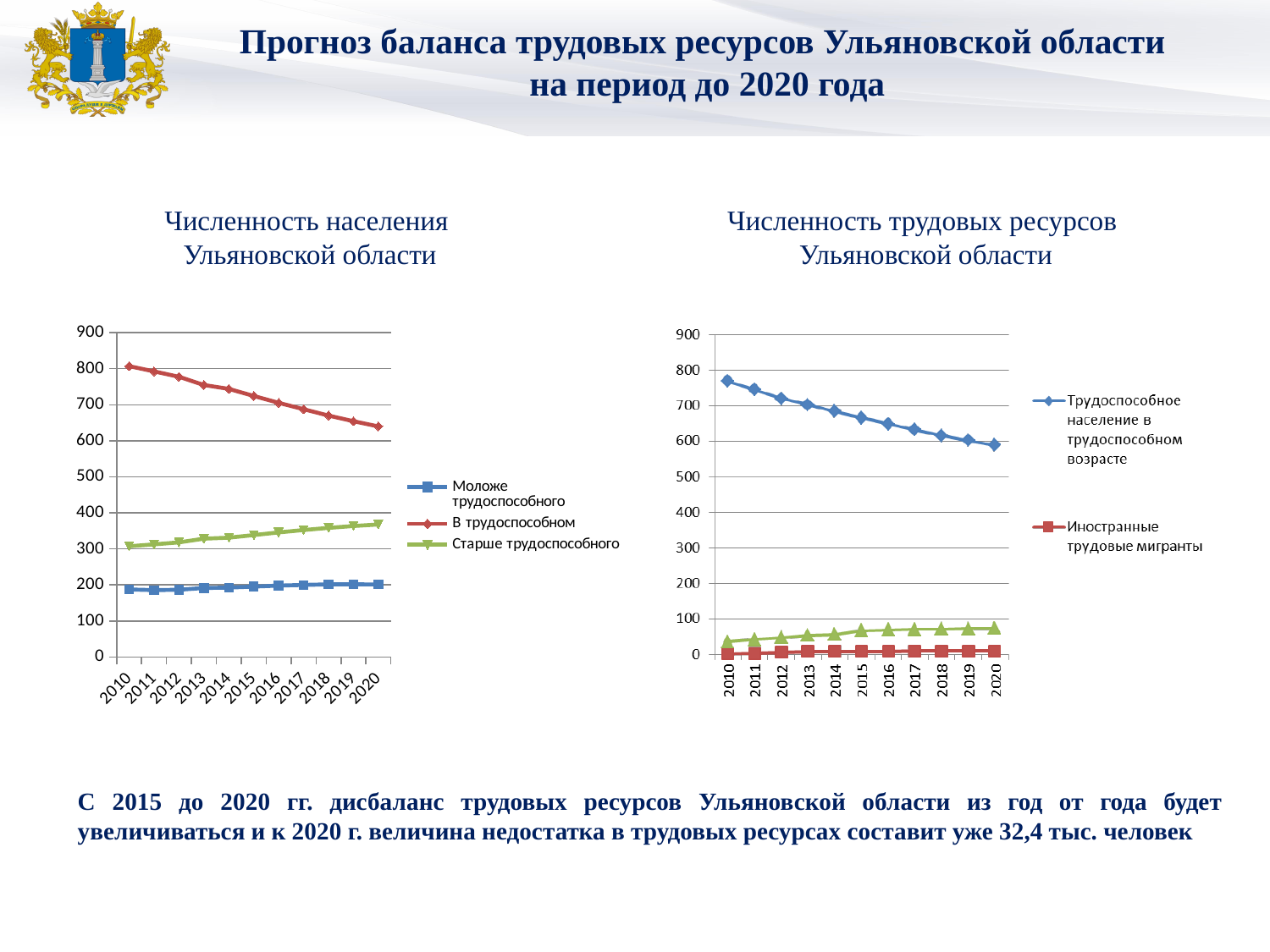
In the right chart 'Численность трудовых ресурсов Ульяновской области', does the 'Трудоспособное население в трудоспособном возрасте' series rise or fall from 2010 to 2020? fall How many years are shown on the x axis of the left chart 'Численность населения Ульяновской области'? 11 In the right chart 'Численность трудовых ресурсов Ульяновской области', is the value for 'Иностранные трудовые мигранты' in 2020 greater or less than 100? less In the left chart 'Численность населения Ульяновской области', which series has the highest values? В трудоспособном What kind of chart is the left chart, 'Численность населения Ульяновской области'? line chart In the left chart 'Численность населения Ульяновской области', does the 'В трудоспособном' series rise or fall from 2010 to 2020? fall In the left chart 'Численность населения Ульяновской области', does the 'Старше трудоспособного' series rise or fall from 2010 to 2020? rise How many series does the legend of the left chart 'Численность населения Ульяновской области' list? 3 In the left chart 'Численность населения Ульяновской области', which is larger in 2020: 'Старше трудоспособного' or 'Моложе трудоспособного'? Старше трудоспособного How many series does the legend of the right chart 'Численность трудовых ресурсов Ульяновской области' list? 2 In the left chart 'Численность населения Ульяновской области', is the value for 'В трудоспособном' in 2020 greater or less than 700? less In the left chart 'Численность населения Ульяновской области', is the value for 'Старше трудоспособного' in 2020 greater or less than 300? greater